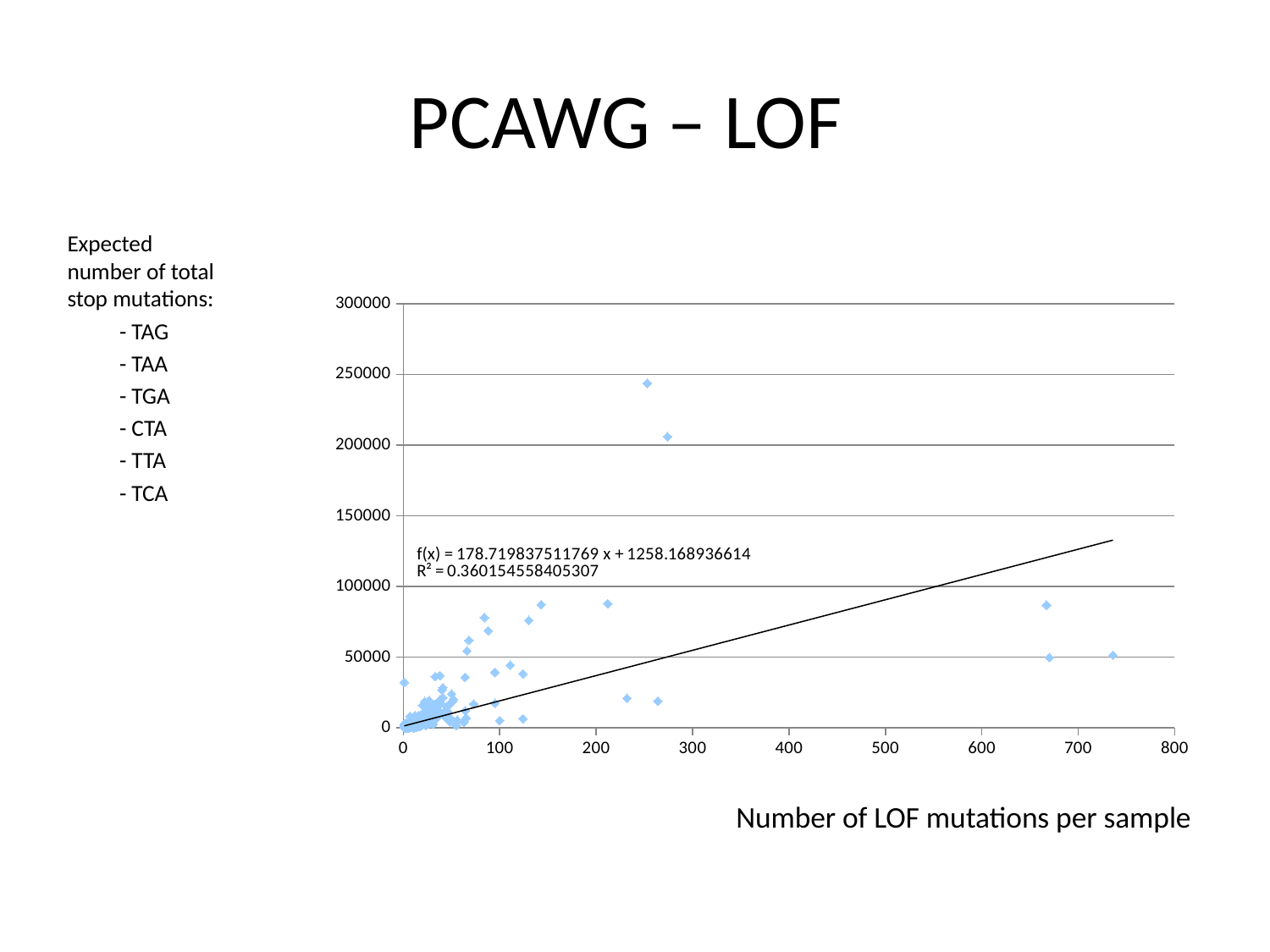
Does the fitted trend line rise or fall as the number of LOF mutations per sample increases? rises What is the label of the x axis? Number of LOF mutations per sample What R² value is printed on the chart for the fitted line? 0.360154558405307 Is the y value of the highest plotted point greater or less than 250000? less Is the y value of the highest plotted point greater or less than 200000? greater Is the x value of the rightmost plotted point greater or less than 700? greater What kind of chart is shown on the slide? scatter chart